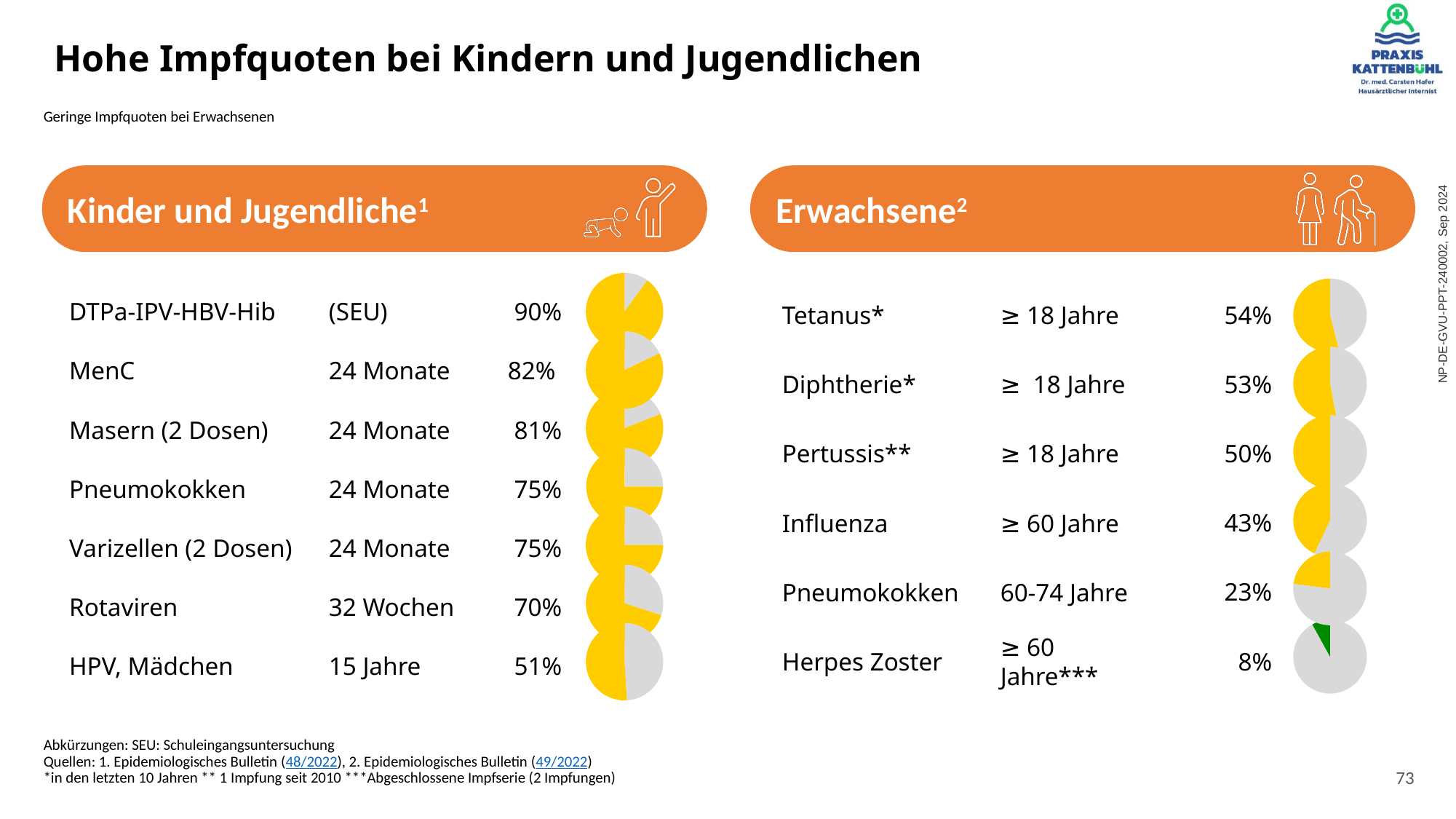
What is the difference between the Pneumokokken rate in the "Kinder und Jugendliche" panel and the Pneumokokken rate in the "Erwachsene" panel? 52 percentage points In the "Kinder und Jugendliche" panel, what is the vaccination rate shown for MenC? 82% How many vaccinations are listed in the "Kinder und Jugendliche" panel? 7 What kind of chart is used to show each vaccination rate on the slide? Pie chart In the "Erwachsene" panel, which vaccination has the highest rate? Tetanus* In the "Kinder und Jugendliche" panel, which vaccination has the highest rate? DTPa-IPV-HBV-Hib Which is larger: the rate for Rotaviren in the "Kinder und Jugendliche" panel or the rate for Tetanus* in the "Erwachsene" panel? Rotaviren In the "Erwachsene" panel, which vaccination has the lowest rate? Herpes Zoster In the "Erwachsene" panel, what is the vaccination rate shown for Herpes Zoster? 8% In the "Kinder und Jugendliche" panel, which vaccination has the lowest rate? HPV, Mädchen How many vaccinations are listed in the "Erwachsene" panel? 6 In the "Erwachsene" panel, what is the vaccination rate shown for Influenza? 43%